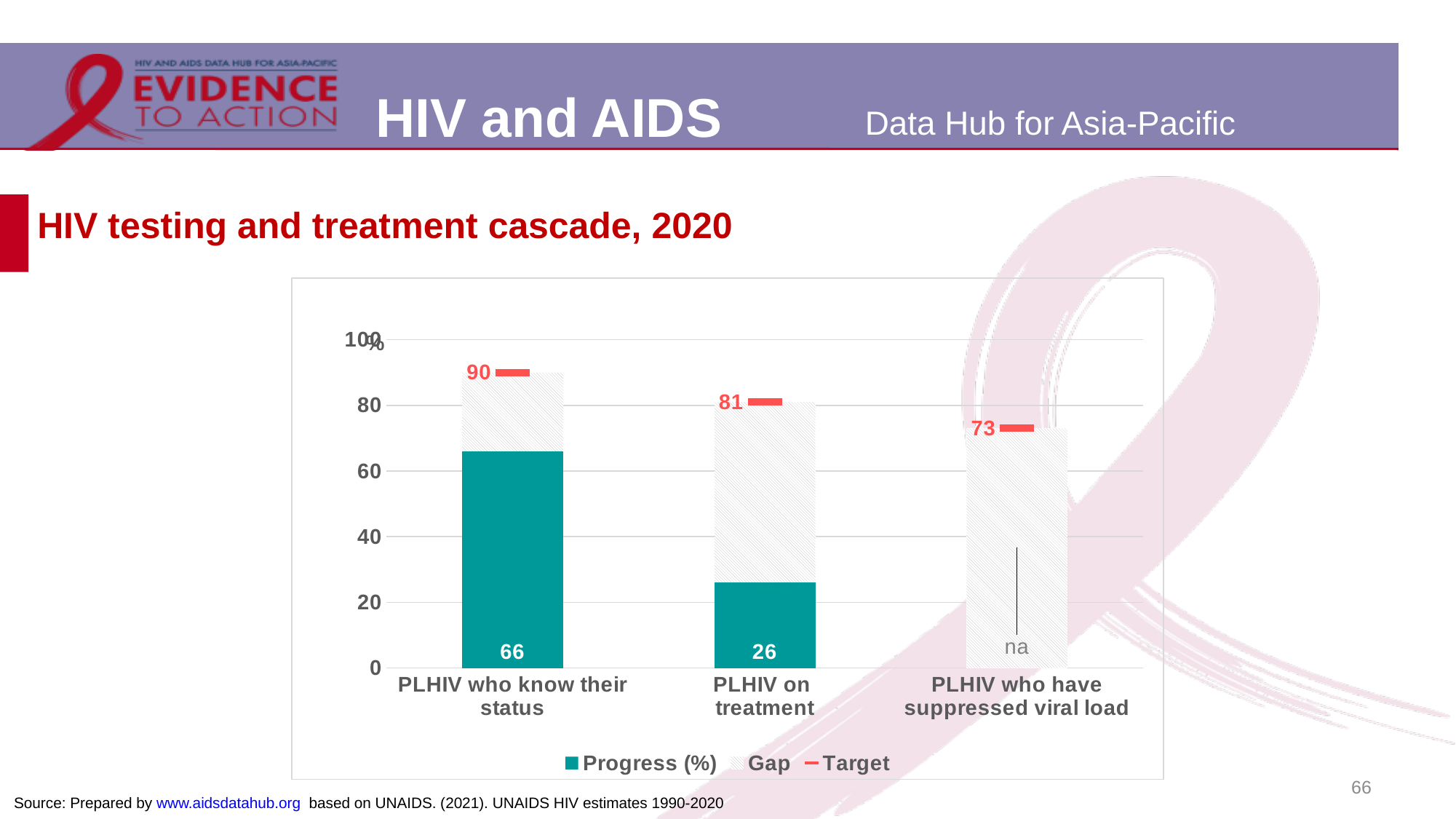
What is the Target value for PLHIV who know their status? 90 What is the title of the chart? HIV testing and treatment cascade, 2020 Is the Progress (%) value for PLHIV on treatment greater or less than 40? less Which category has the highest Target value? PLHIV who know their status Which category has the lowest Target value? PLHIV who have suppressed viral load How many series does the legend list? 3 What is the Progress (%) value for PLHIV who know their status? 66 What is shown as the Progress (%) value for PLHIV who have suppressed viral load? na What is the Progress (%) value for PLHIV on treatment? 26 What is the Target value for PLHIV who have suppressed viral load? 73 What is the Target value for PLHIV on treatment? 81 What is the difference between the Target and the Progress (%) value for PLHIV who know their status? 24